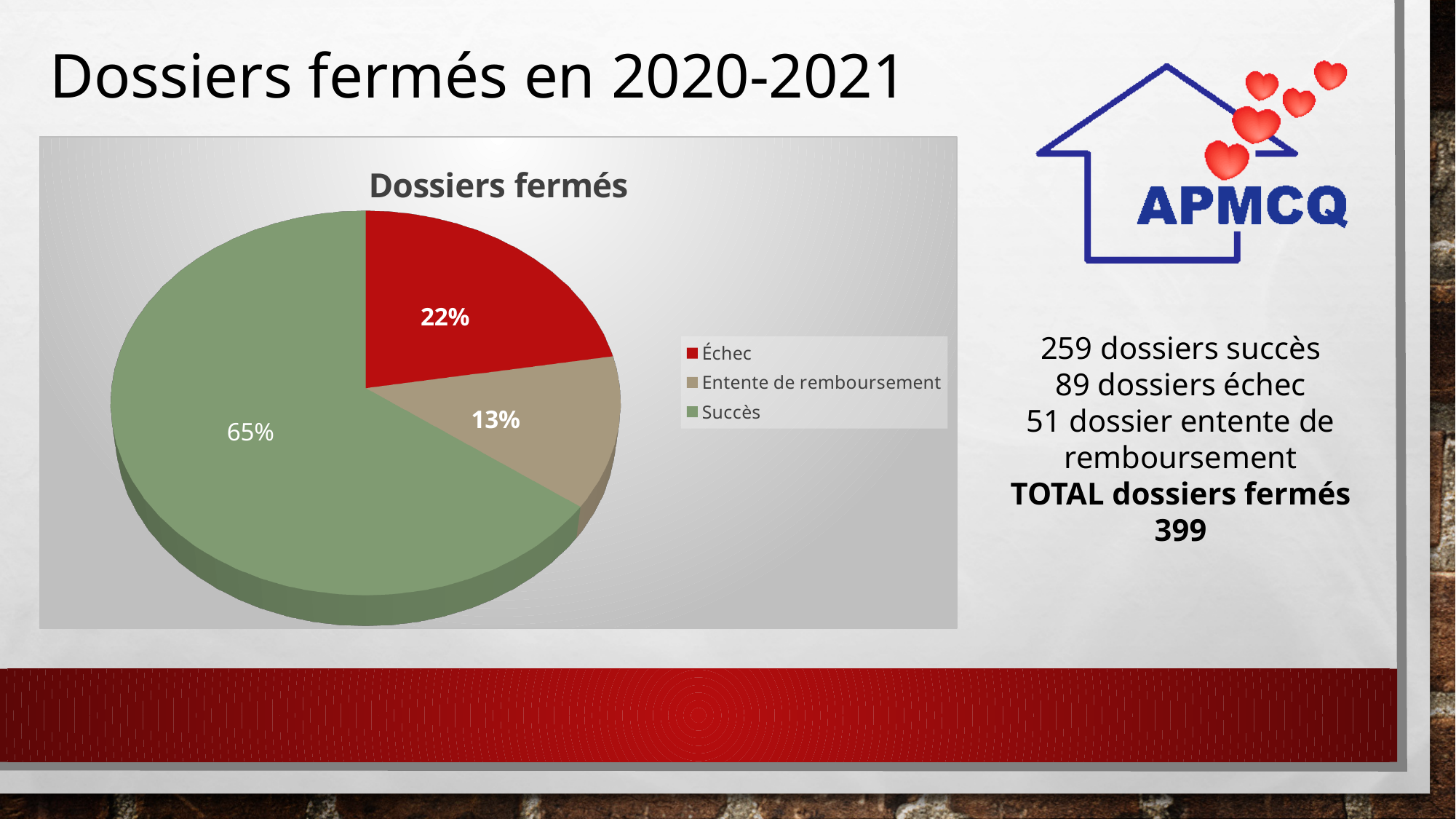
What percentage of the pie does the Entente de remboursement slice represent? 13% Which category has the largest slice of the pie? Succès What is the difference in percentage points between the Échec slice and the Entente de remboursement slice? 9% What is the difference in percentage points between the Succès slice and the Échec slice? 43% What is the title of the chart? Dossiers fermés What percentage of the pie does the Succès slice represent? 65% What type of chart is shown on the slide? Pie chart Which slice is larger, Échec or Entente de remboursement? Échec Which category has the smallest slice of the pie? Entente de remboursement What percentage of the pie does the Échec slice represent? 22% How many categories does the pie chart show? 3 What colour is the Succès slice in the pie chart? Green